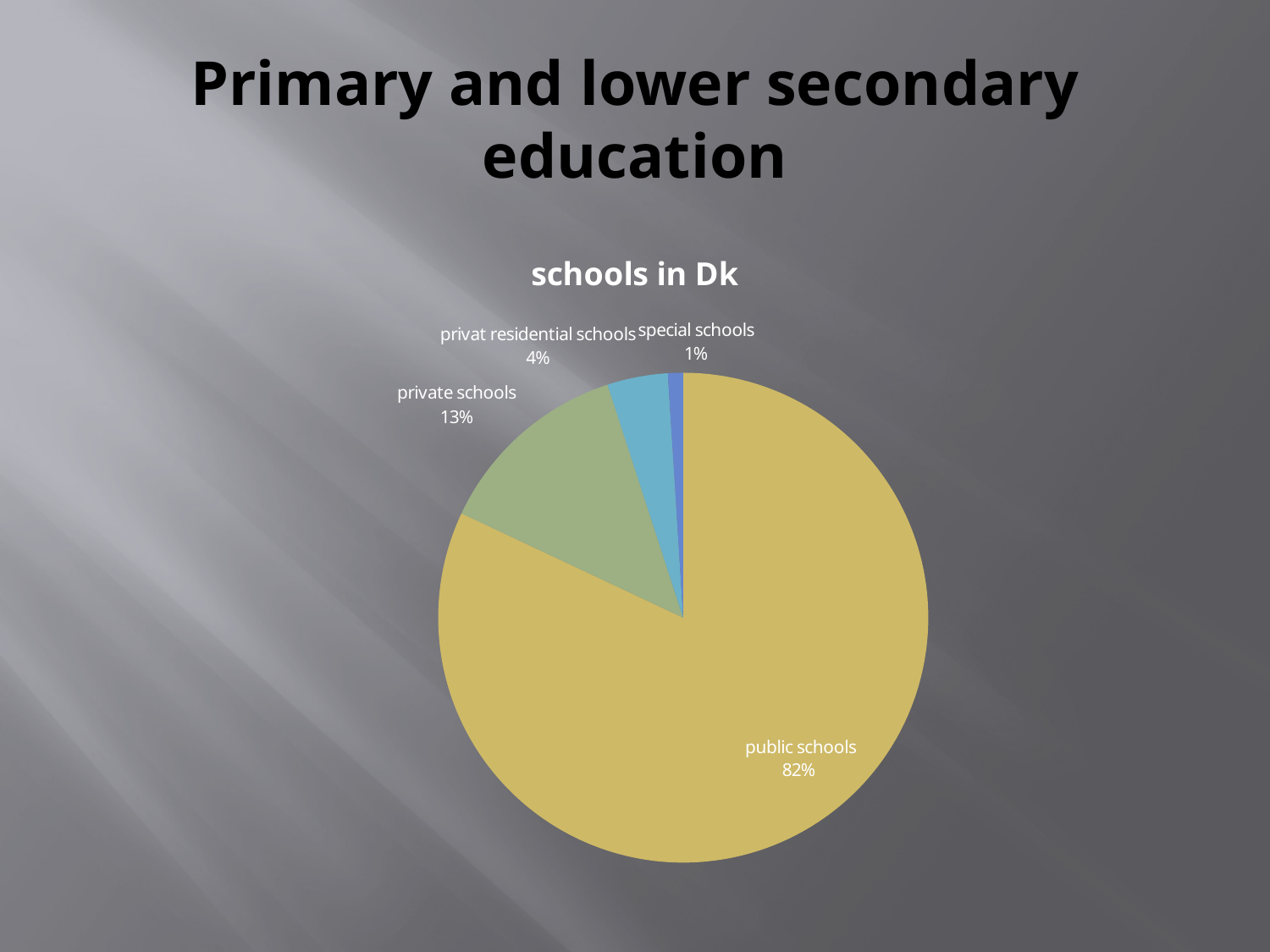
What type of chart is shown on the slide? pie chart What share of the pie do special schools account for? 1% How many slices does the pie chart have? 4 What is the difference in percentage points between public schools and private schools? 69 What share of the pie do private schools account for? 13% What colour is the public schools slice? yellow Which category has the smallest slice of the pie? special schools Which is larger, the share for private schools or the share for privat residential schools? private schools Which category has the largest slice of the pie? public schools What is the title of the chart? schools in Dk What share of the pie do public schools account for? 82%